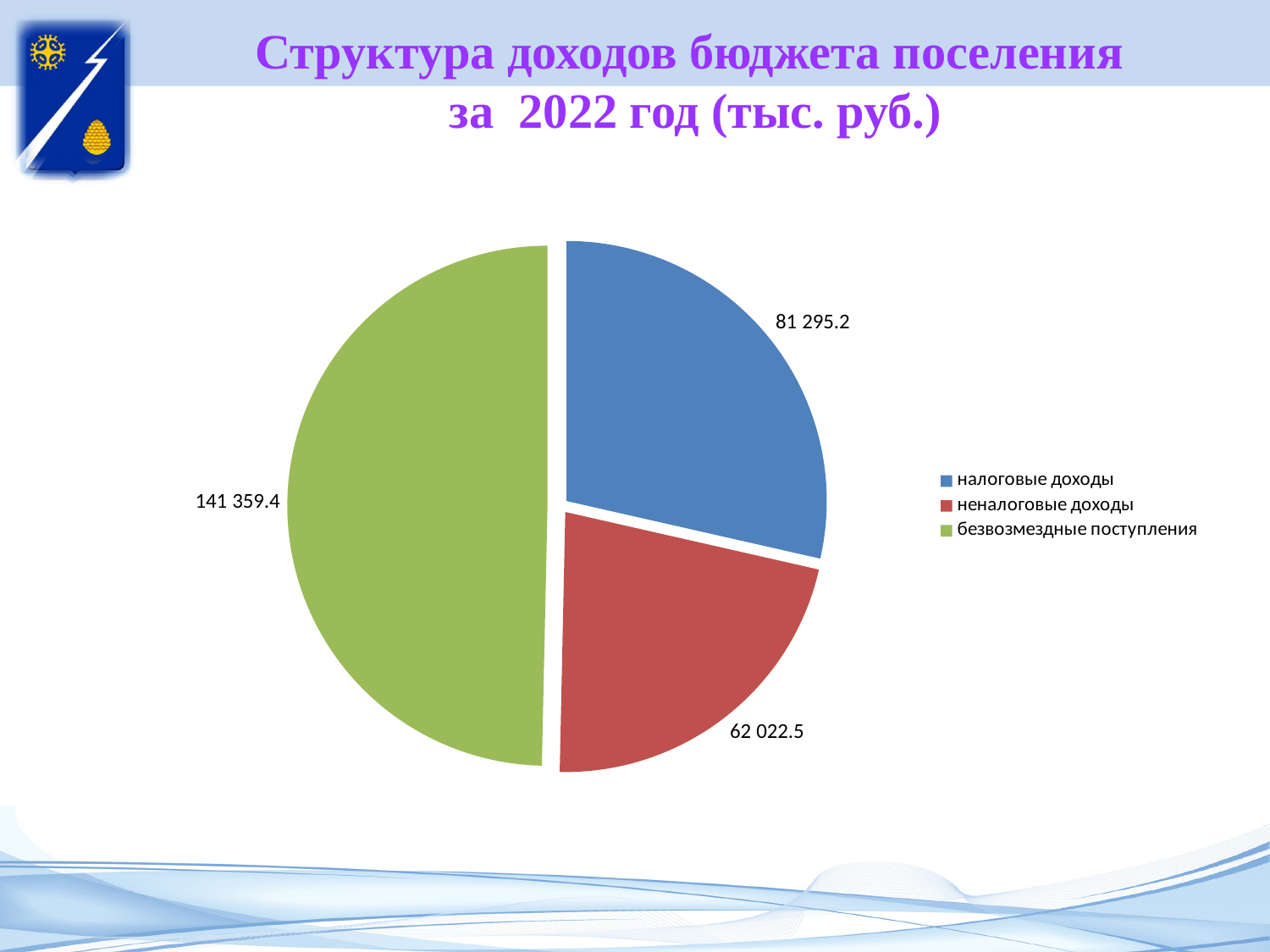
What is the difference between налоговые доходы and неналоговые доходы? 19 272.7 What type of chart is shown on the slide? pie chart Which category has the smallest slice of the pie? неналоговые доходы What is the value for неналоговые доходы? 62 022.5 What is the total of all three slices? 284 677.1 What colour is the slice for безвозмездные поступления? green What is the difference between безвозмездные поступления and налоговые доходы? 60 064.2 Which category has the largest slice of the pie? безвозмездные поступления Which is larger, налоговые доходы or неналоговые доходы? налоговые доходы What is the value for налоговые доходы? 81 295.2 What is the value for безвозмездные поступления? 141 359.4 How many slices does the pie chart have? 3